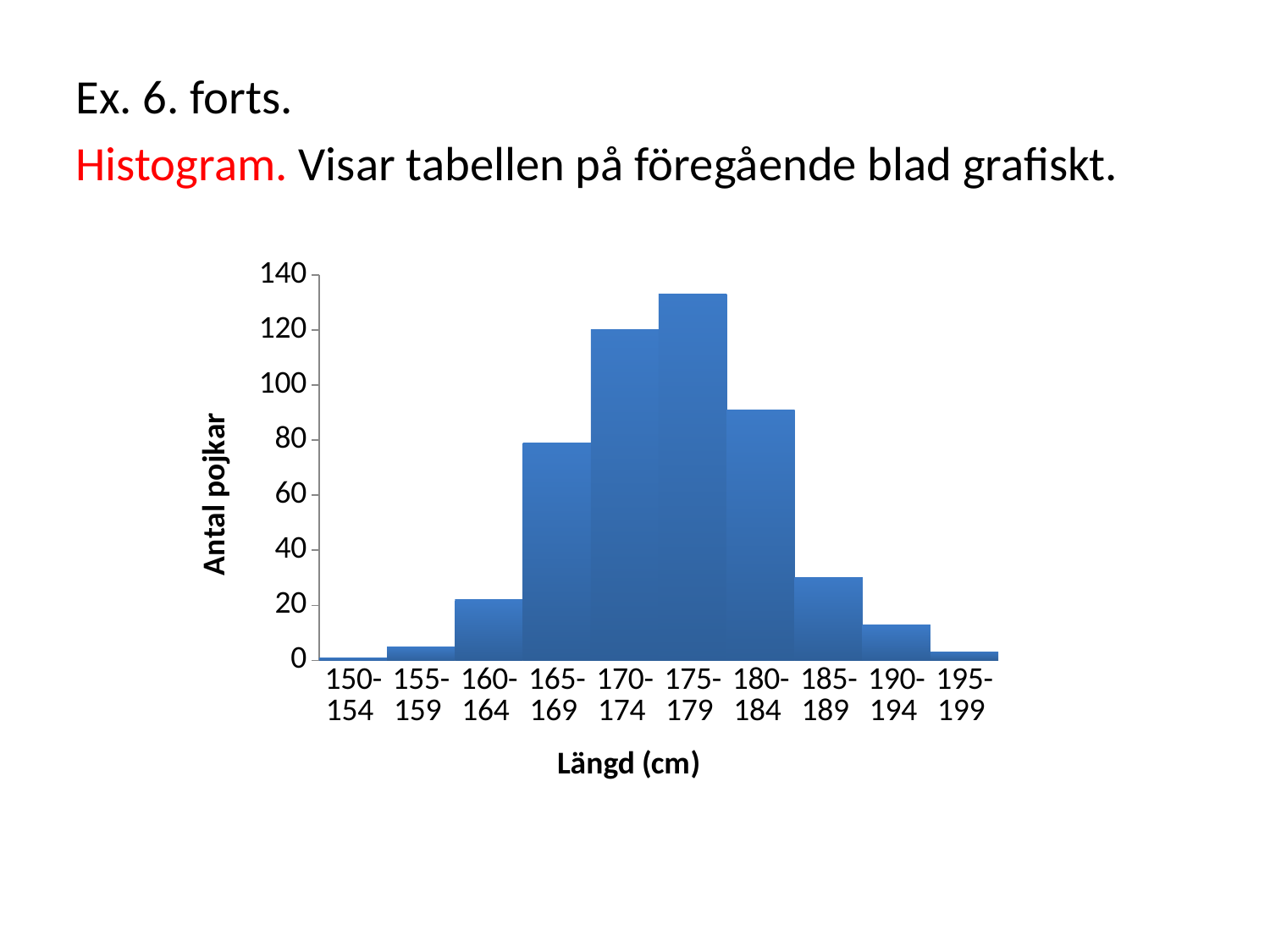
Is the value for 185-189 greater or less than 40? less Is the value for 165-169 greater or less than 100? less What kind of chart is shown on the slide? bar chart How many length categories are shown on the x axis? 10 What is the label of the vertical axis? Antal pojkar Which length category has the highest number of boys (Antal pojkar)? 175-179 Is the value for 175-179 greater or less than 120? greater What is the label of the horizontal axis? Längd (cm) Which is larger, the value for 170-174 or the value for 180-184? 170-174 Which is larger, the value for 165-169 or the value for 185-189? 165-169